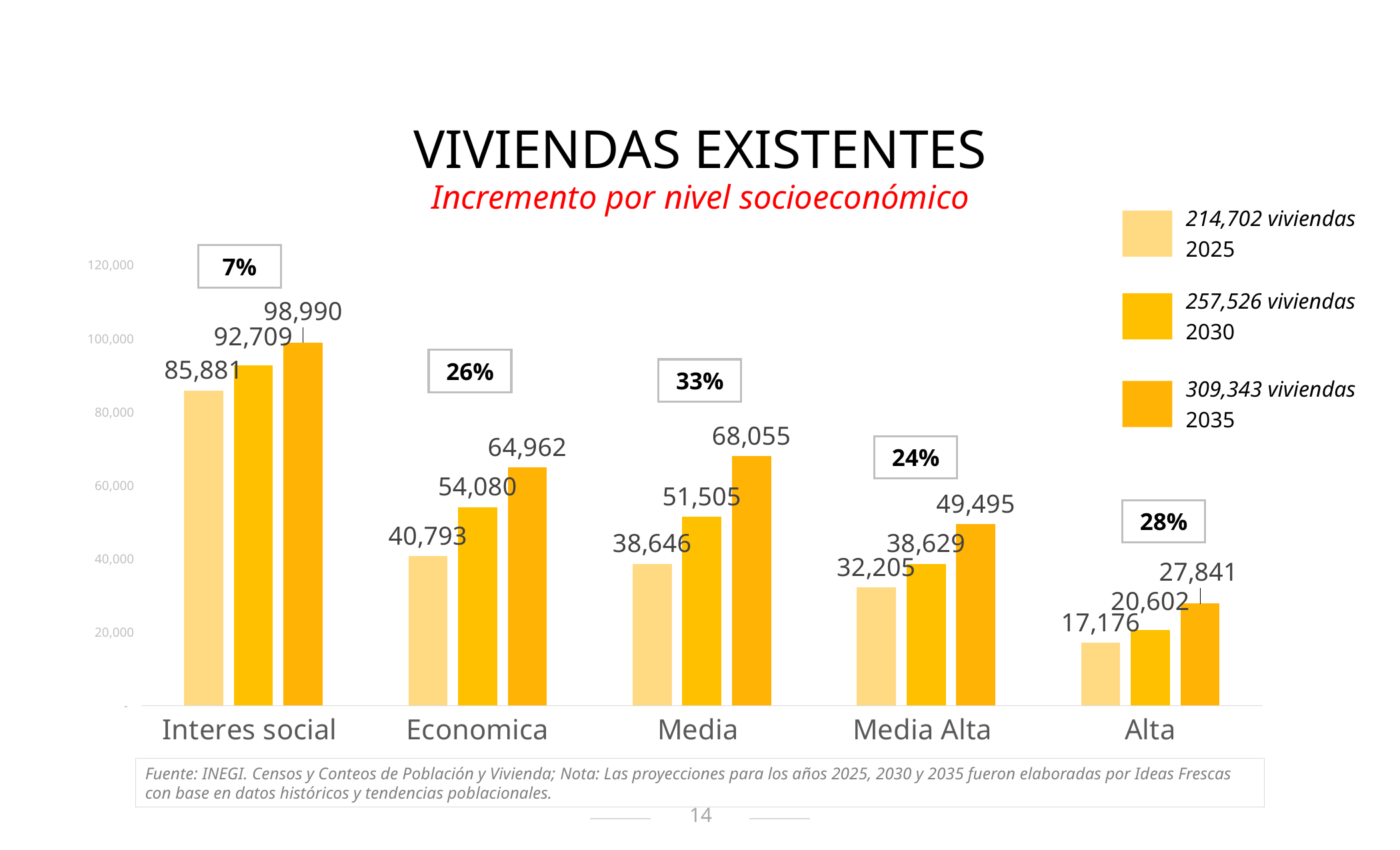
What is the difference between the 2035 and 2030 values for Media? 16,550 What is the 2035 value for Media? 68,055 What percentage is shown in the box above the Media bars? 33% Which category has the lowest 2025 value? Alta How many categories are shown on the x axis? 5 How many series does the legend list? 3 What is the 2025 value for Interes social? 85,881 What kind of chart is shown on the slide? Bar chart Which category has the highest 2035 value? Interes social What is the 2030 value for Alta? 20,602 Which is larger, the 2035 value for Economica or the 2035 value for Media? Media What is the difference between the 2035 and 2025 values for Interes social? 13,109